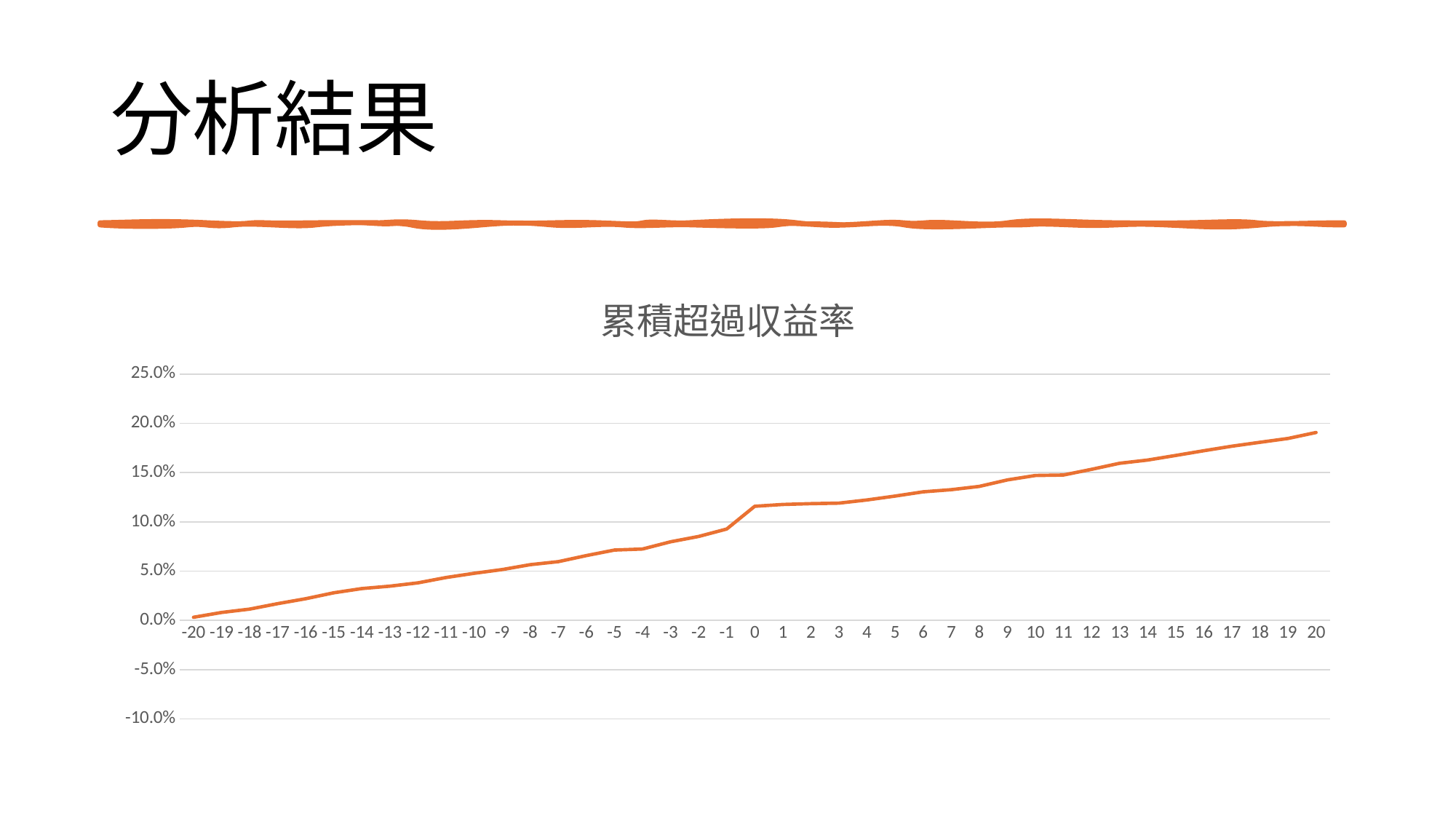
Is the value at x = -5 greater or less than 5.0%? greater Which is larger, the value at x = 10 or the value at x = -10? x = 10 At which x value is the plotted value highest? 20 Is the value at x = 0 greater or less than 10.0%? greater What is the title of the chart? 累積超過収益率 At which x value is the plotted value lowest? -20 Do the values rise or fall as the x axis goes from -20 to 20? rise What kind of chart is shown on the slide? line chart Is the value at x = 15 greater or less than 15.0%? greater How many points are plotted along the x axis? 41